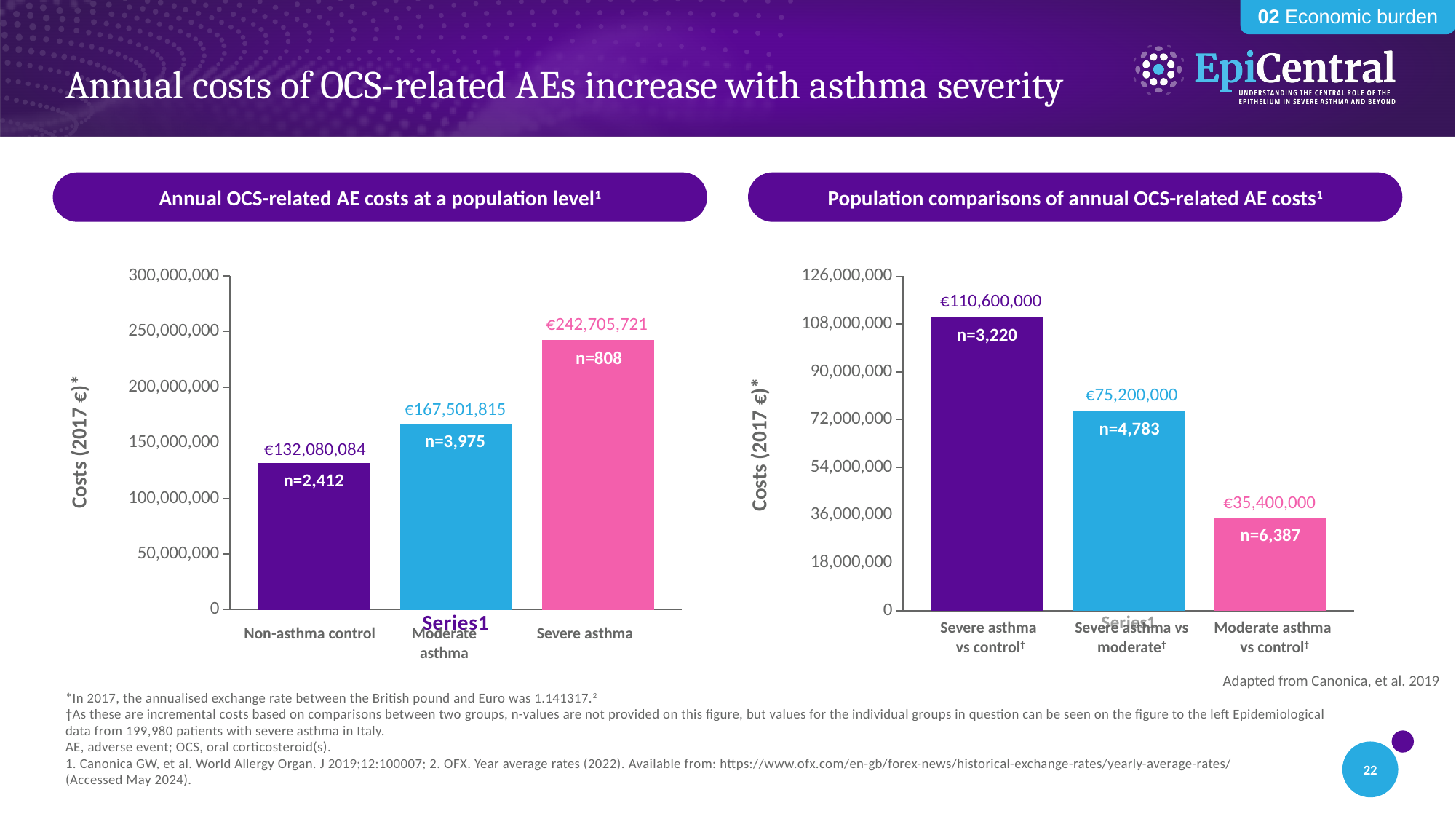
In the 'Annual OCS-related AE costs at a population level' chart, what is the annual cost for Non-asthma control? €132,080,084 In the 'Population comparisons of annual OCS-related AE costs' chart, which is larger: Severe asthma vs moderate or Moderate asthma vs control? Severe asthma vs moderate In the 'Annual OCS-related AE costs at a population level' chart, what is the difference in cost between Severe asthma and Non-asthma control? €110,625,637 In the 'Annual OCS-related AE costs at a population level' chart, what is the n value shown on the Moderate asthma bar? n=3,975 How many bars are plotted in the 'Population comparisons of annual OCS-related AE costs' chart? 3 In the 'Population comparisons of annual OCS-related AE costs' chart, what is the difference between Severe asthma vs control and Severe asthma vs moderate? €35,400,000 In the 'Annual OCS-related AE costs at a population level' chart, do the costs rise or fall from Non-asthma control to Severe asthma along the x axis? Rise In the 'Annual OCS-related AE costs at a population level' chart, which category has the lowest cost? Non-asthma control In the 'Annual OCS-related AE costs at a population level' chart, which category has the highest cost? Severe asthma In the 'Population comparisons of annual OCS-related AE costs' chart, what is the cost for Moderate asthma vs control? €35,400,000 In the 'Population comparisons of annual OCS-related AE costs' chart, what is the cost for Severe asthma vs control? €110,600,000 In the 'Annual OCS-related AE costs at a population level' chart, what is the annual cost for Severe asthma? €242,705,721